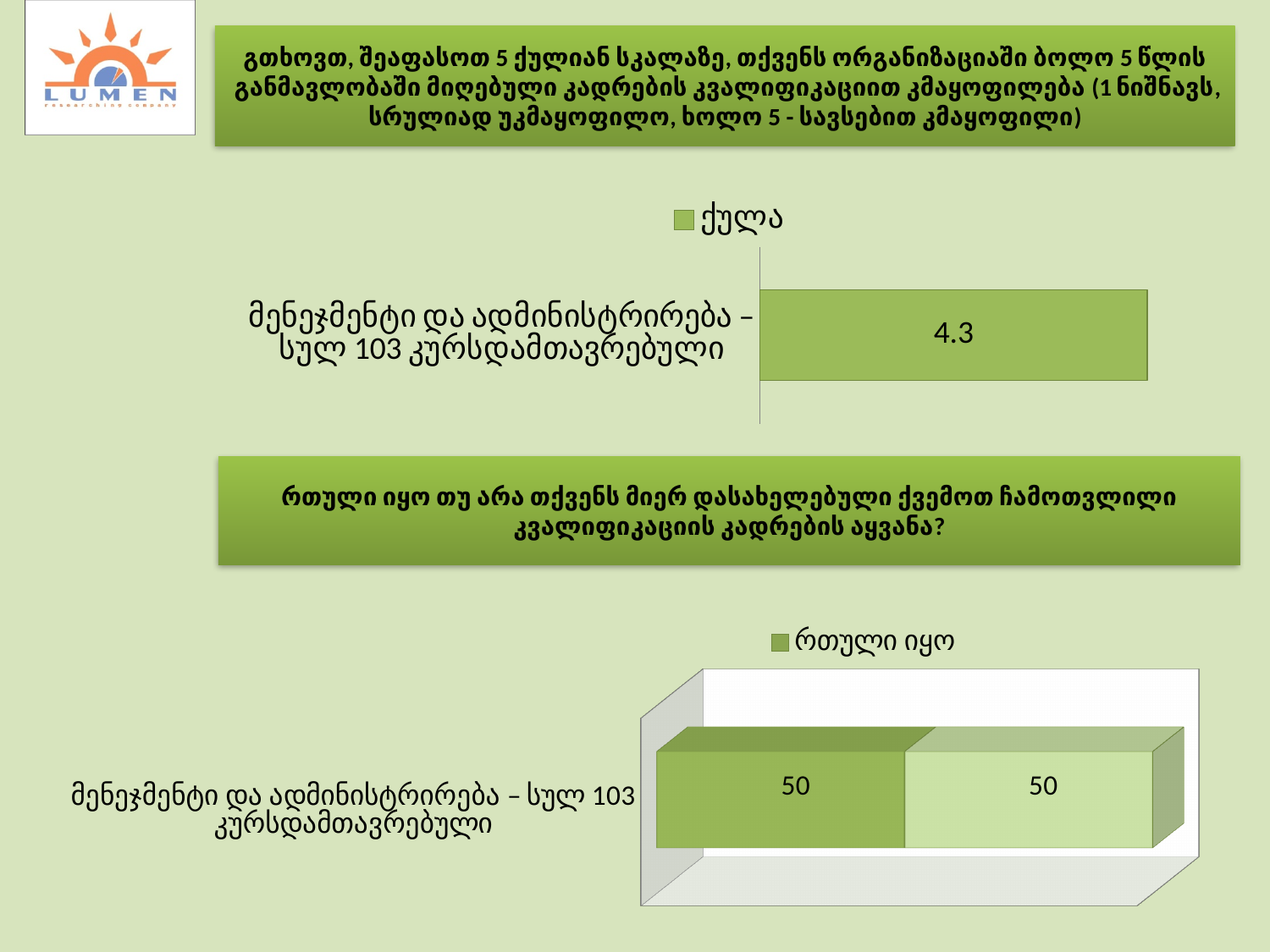
How many categories are plotted in the bottom chart? 1 How many categories are plotted in the top chart? 1 In the top chart, what series name does the legend show? ქულა In the top chart, what is the value shown for "მენეჯმენტი და ადმინისტრირება – სულ 103 კურსდამთავრებული"? 4.3 In the bottom chart, what is the total of the two segments of the stacked bar? 100 How many series does the legend of the bottom chart list? 1 In the bottom chart, what value is printed on the lighter green segment of the bar? 50 What kind of chart is the bottom chart on the slide? bar chart In the bottom chart, what entry does the legend show? რთული იყო In the bottom chart, what value is printed on the darker green segment of the bar? 50 How many series does the legend of the top chart list? 1 What kind of chart is the top chart on the slide? bar chart